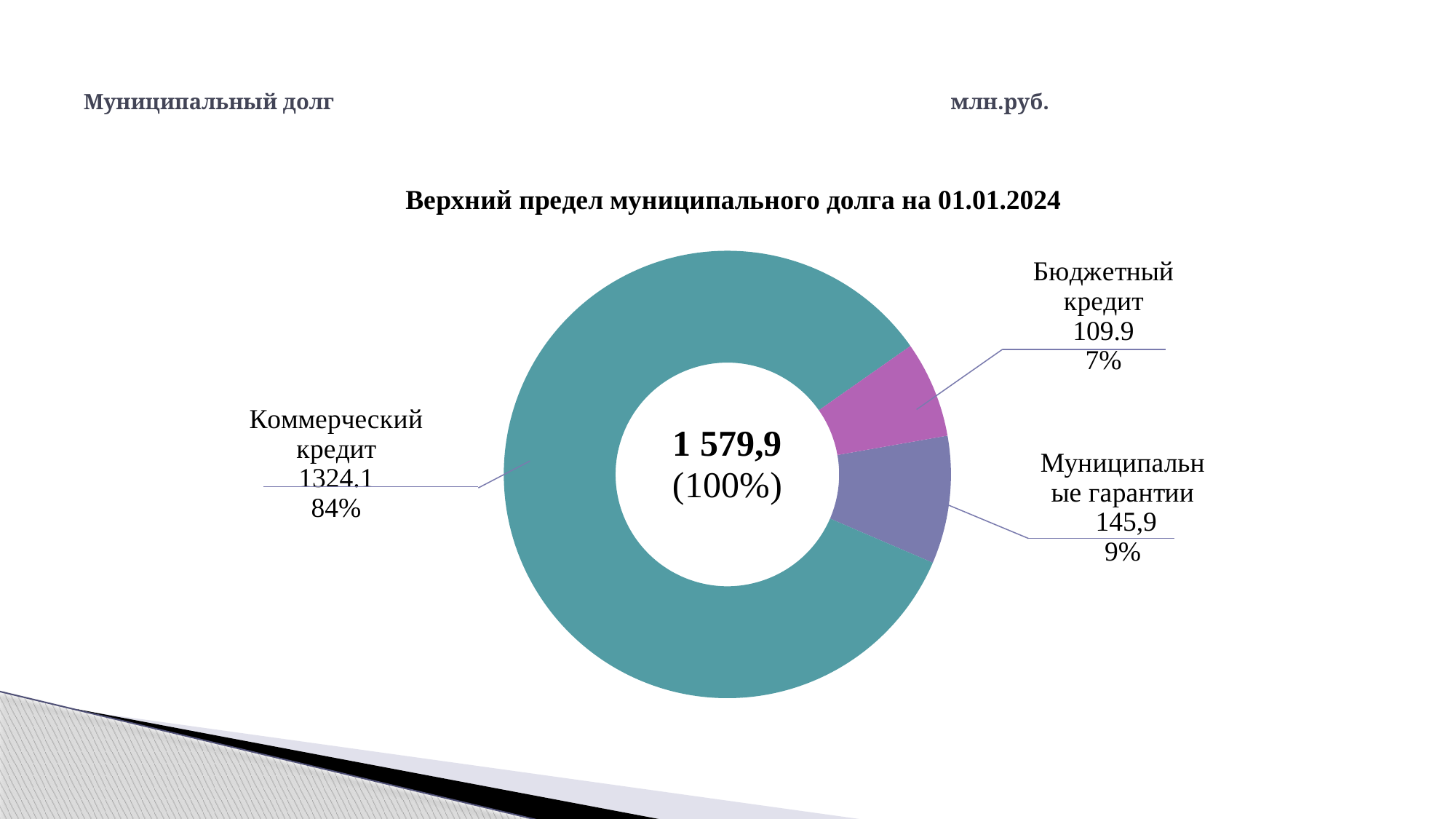
What type of chart is shown on the slide? Pie (donut) chart What is the value for Коммерческий кредит? 1324.1 What is the value for Бюджетный кредит? 109.9 Which category has the largest value? Коммерческий кредит What is the value for Муниципальные гарантии? 145,9 What share of the total does Муниципальные гарантии represent? 9% Which is larger: Муниципальные гарантии or Бюджетный кредит? Муниципальные гарантии What share of the total does Коммерческий кредит represent? 84% What share of the total does Бюджетный кредит represent? 7% What is the total value shown in the centre of the chart? 1 579,9 What is the title of the chart? Верхний предел муниципального долга на 01.01.2024 Which category has the smallest value? Бюджетный кредит